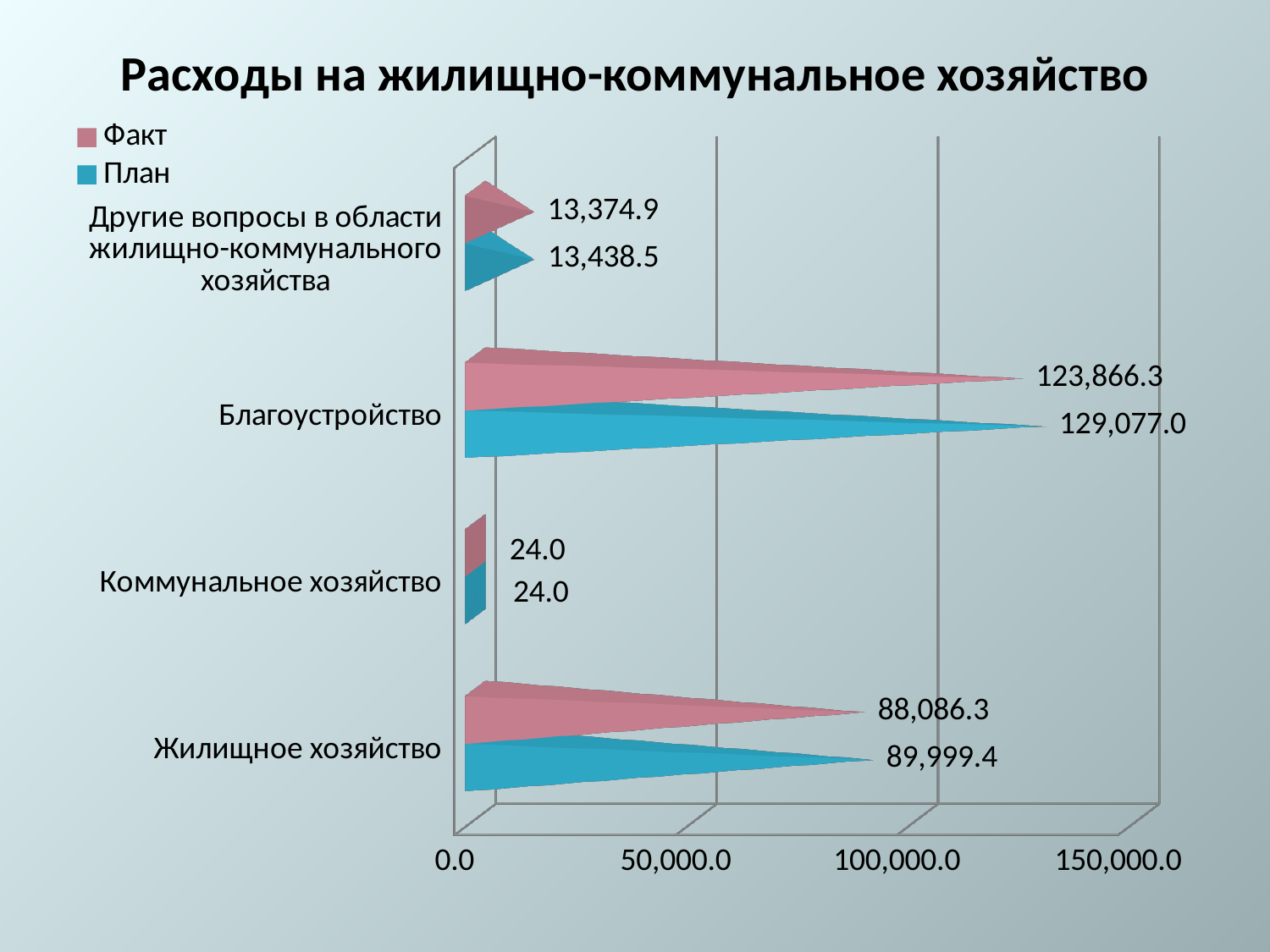
How many series does the legend list? 2 Which is larger for Жилищное хозяйство, the План value or the Факт value? План What is the Факт value for Другие вопросы в области жилищно-коммунального хозяйства? 13,374.9 Is the Факт value for Благоустройство greater or less than 100,000.0? greater What is the Факт value for Жилищное хозяйство? 88,086.3 What is the difference between the План and Факт values for Благоустройство? 5,210.7 How many categories are shown on the chart? 4 What is the План value for Благоустройство? 129,077.0 What kind of chart is shown on the slide? Bar chart What is the title of the chart? Расходы на жилищно-коммунальное хозяйство Which category has the lowest Факт value? Коммунальное хозяйство Which category has the highest План value? Благоустройство